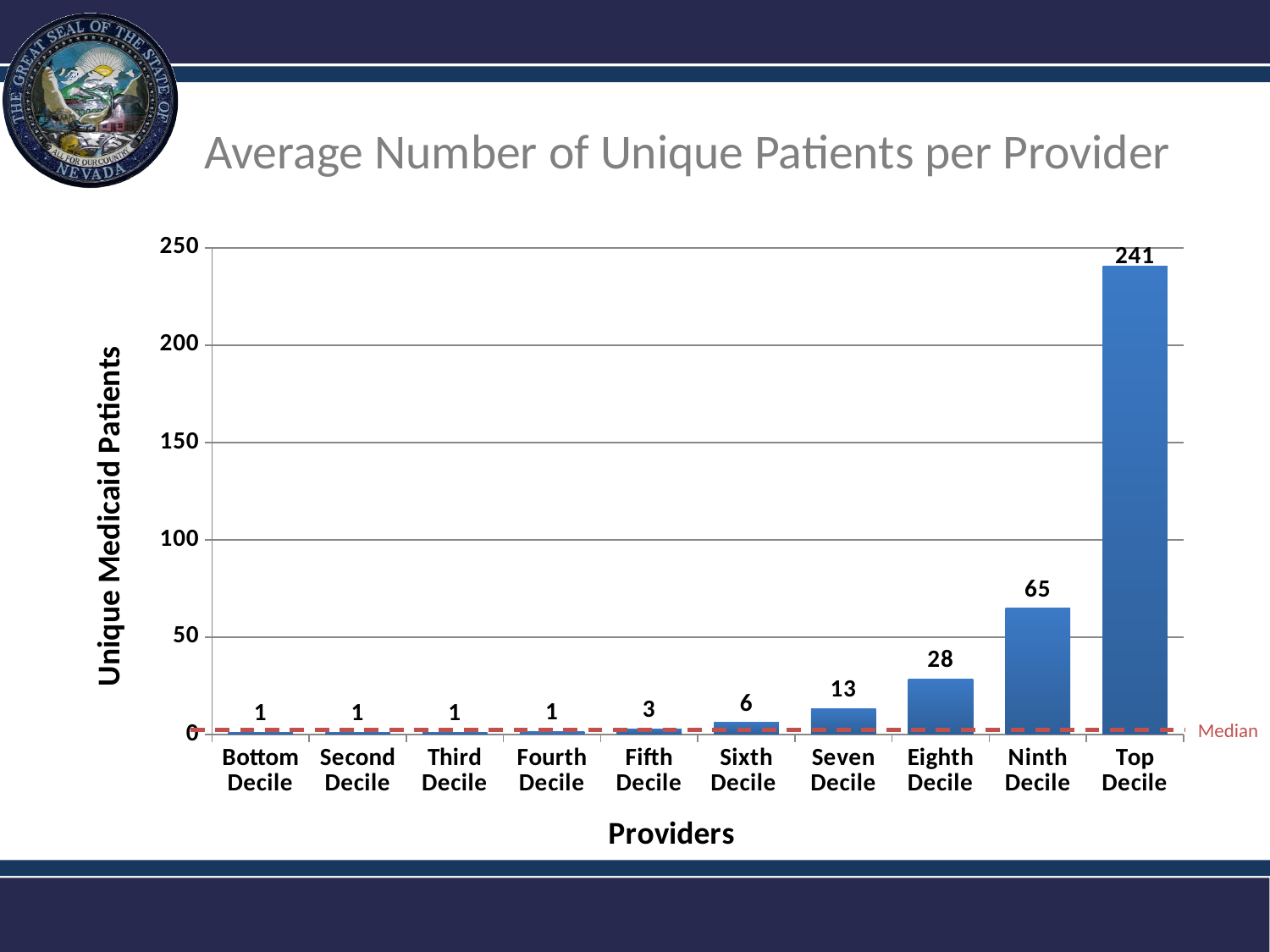
What is the value for the Eighth Decile? 28 How many decile categories are shown on the x axis? 10 Which is larger, the value for the Fifth Decile or the Sixth Decile? Sixth Decile What is the difference between the Top Decile and the Ninth Decile values? 176 What kind of chart is shown on the slide? bar chart Is the value for the Ninth Decile greater or less than 50? greater What is the value for the Ninth Decile? 65 What is the value for the Sixth Decile? 6 What does the red dashed horizontal line on the chart represent? Median What is the value for the Top Decile? 241 What is the difference between the Eighth Decile and the Seven Decile values? 15 Which decile has the highest average number of unique patients per provider? Top Decile